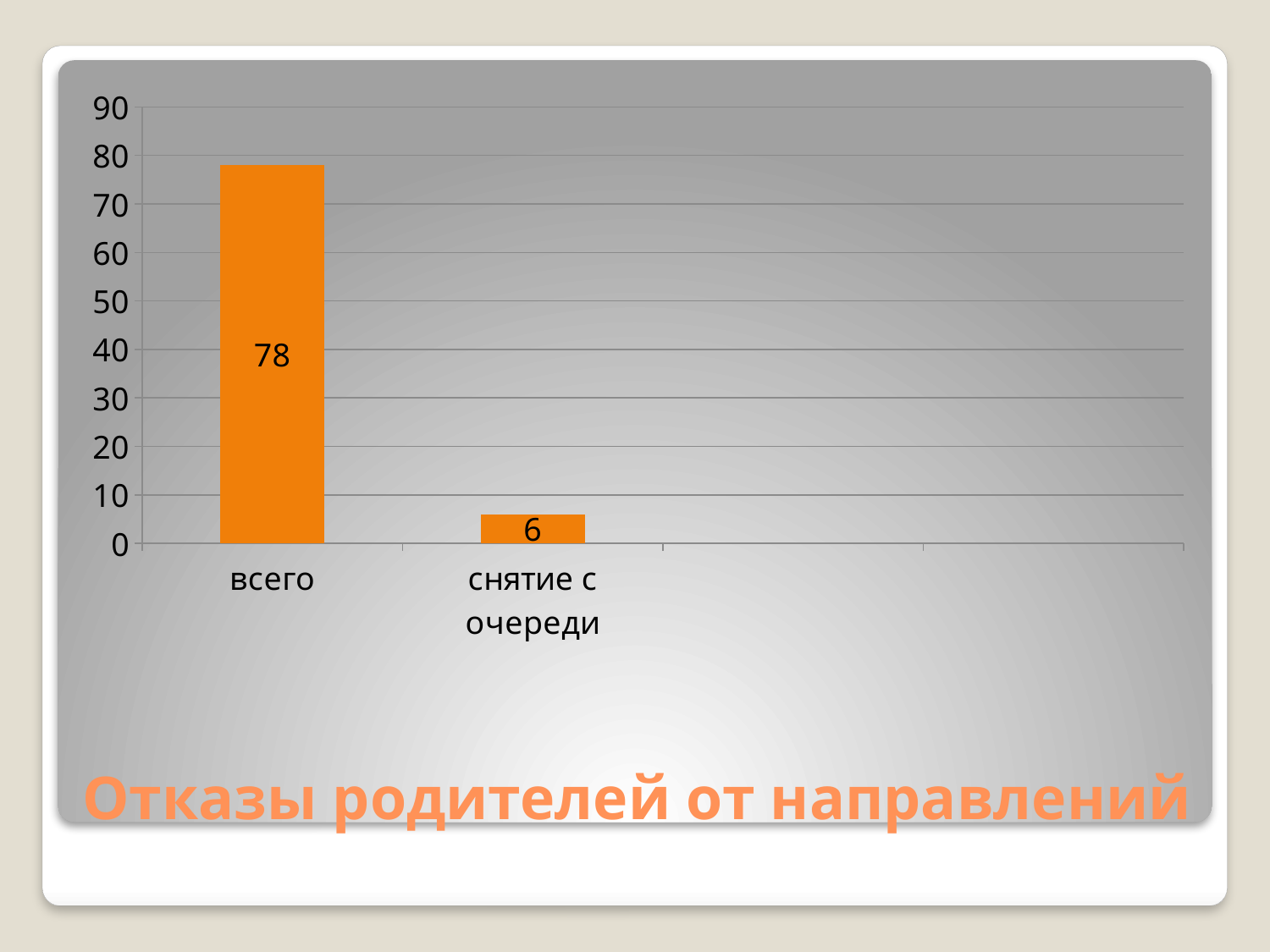
What is the difference between the values for "всего" and "снятие с очереди"? 72 Which category has the highest value? всего Which is larger, the value for "всего" or the value for "снятие с очереди"? всего What kind of chart is shown on the slide? bar chart What is the value for "всего"? 78 What is the value for "снятие с очереди"? 6 Is the value for "всего" greater or less than 70? greater Which category has the lowest value? снятие с очереди Is the value for "снятие с очереди" greater or less than 10? less What colour are the bars in the chart? orange What is the title of the chart? Отказы родителей от направлений How many categories are shown on the x axis? 2